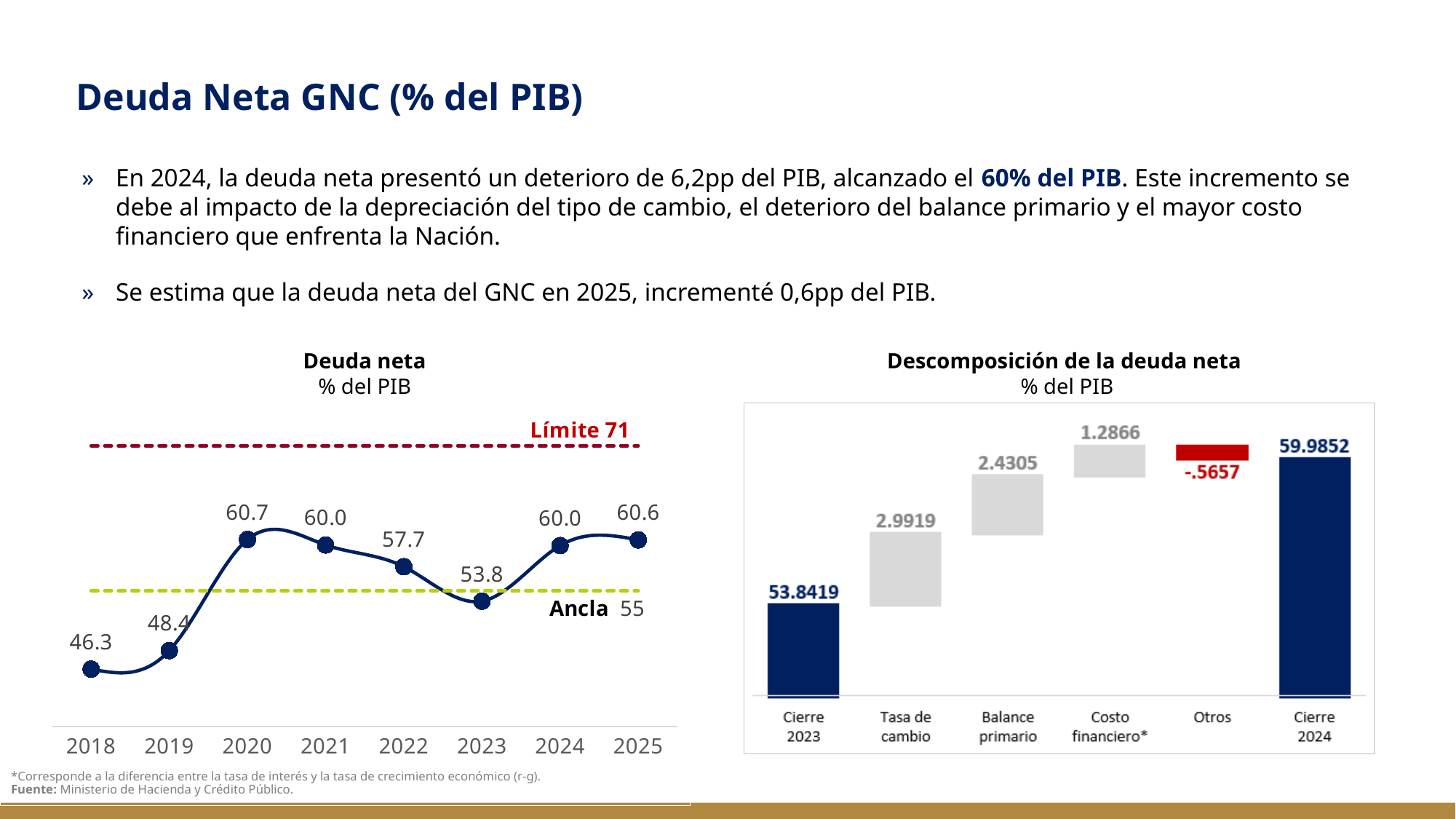
In the 'Descomposición de la deuda neta' chart, what is the value for 'Cierre 2023'? 53.8419 In the 'Deuda neta' chart, is the value for 2022 larger than the value for 2023? Yes, 2022 (57.7) In the 'Deuda neta' chart, what is the value for 2020? 60.7 In the 'Deuda neta' chart, what value is labelled as the 'Límite'? 71 What kind of chart is the 'Descomposición de la deuda neta' chart? Bar chart (waterfall) In the 'Deuda neta' chart, which year has the lowest value? 2018 In the 'Deuda neta' chart, what is the difference between the 2024 and 2023 values? 6.2 In the 'Descomposición de la deuda neta' chart, which component has a negative value? Otros In the 'Descomposición de la deuda neta' chart, what is the value for 'Tasa de cambio'? 2.9919 In the 'Deuda neta' chart, how many years are plotted on the x axis? 8 In the 'Deuda neta' chart, what is the value for 2018? 46.3 In the 'Deuda neta' chart, which year has the highest value? 2020